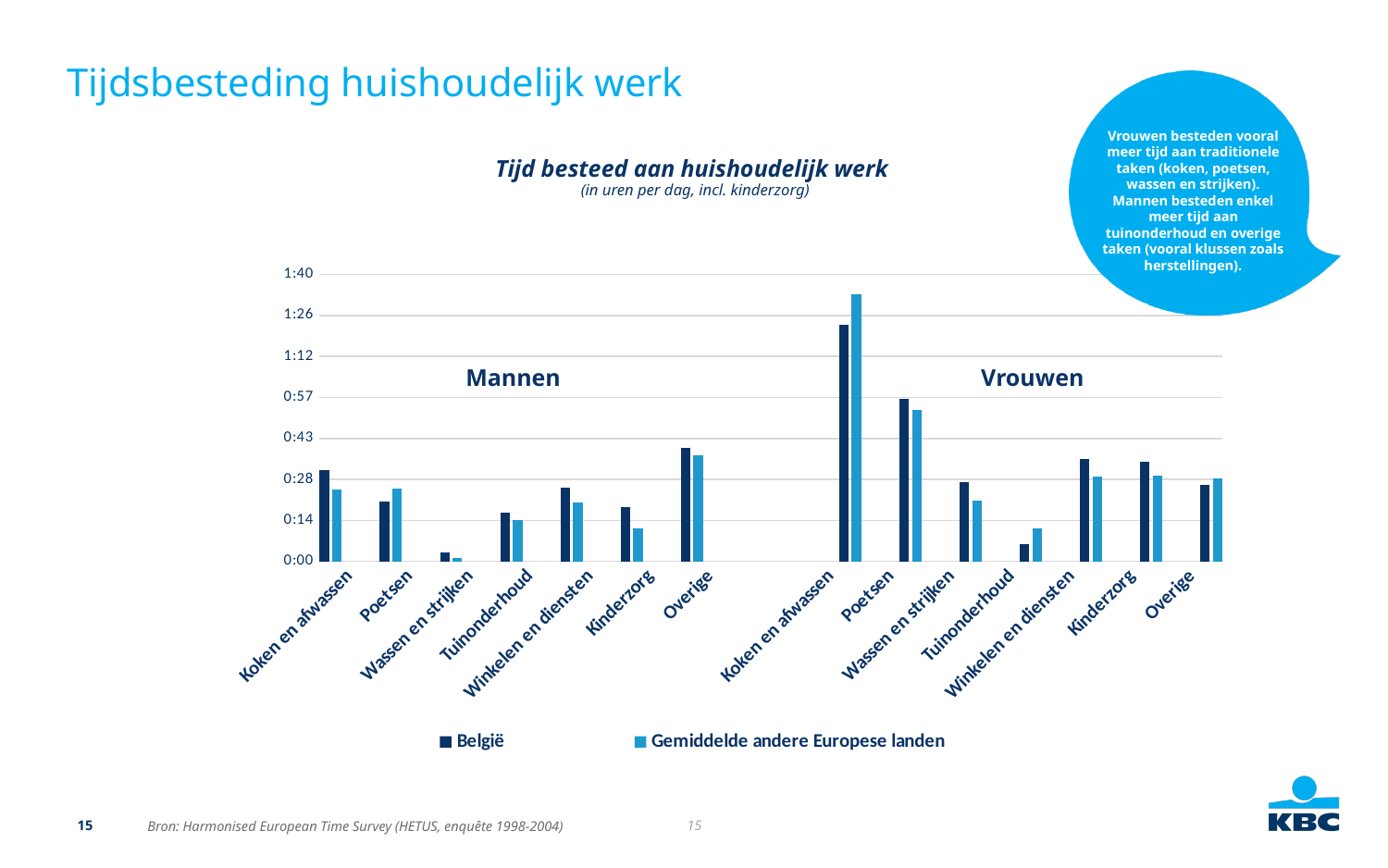
What is the title of the chart? Tijd besteed aan huishoudelijk werk Is the Gemiddelde andere Europese landen value for Koken en afwassen under Vrouwen greater or less than 1:26? greater How many series does the legend list? 2 For Tuinonderhoud under Vrouwen, which series has the larger value: België or Gemiddelde andere Europese landen? Gemiddelde andere Europese landen How many category groups are plotted along the x axis in total (Mannen and Vrouwen combined)? 14 Is the België value for Overige under Mannen greater or less than 0:28? greater For Kinderzorg under Mannen, which series has the larger value: België or Gemiddelde andere Europese landen? België What kind of chart is shown on the slide? bar chart Is the België value for Koken en afwassen under Vrouwen greater or less than 1:12? greater Which category has the highest bar in the whole chart? Koken en afwassen (Vrouwen) Among the Mannen categories, which has the lowest bars? Wassen en strijken